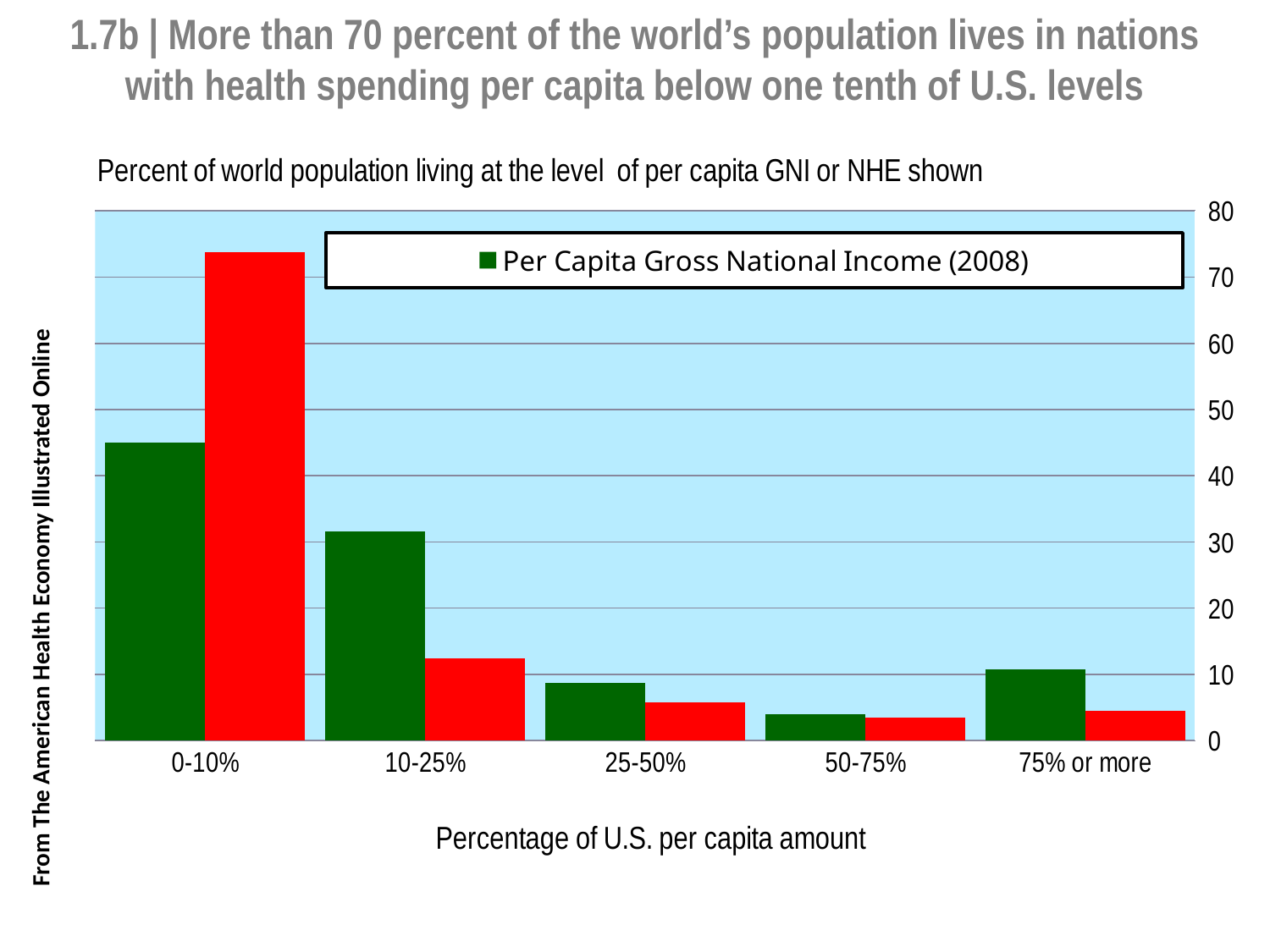
Which category has the highest value for Per Capita Gross National Income (2008)? 0-10% In the 10-25% category, which bar is taller, the green bar or the red bar? the green bar What kind of chart is shown on the slide? bar chart Is the value for Per Capita Gross National Income (2008) in the 0-10% category greater or less than 40? greater Is the value of the red bar in the 0-10% category greater or less than 70? greater Which category has the lowest value for Per Capita Gross National Income (2008)? 50-75% In the 0-10% category, which bar is taller, the green bar or the red bar? the red bar Do the red bars rise or fall from the 0-10% category to the 50-75% category? fall How many categories are shown on the x axis? 5 How many series does the legend list? 1 What is the label of the x axis? Percentage of U.S. per capita amount Is the value for Per Capita Gross National Income (2008) in the 75% or more category greater or less than 20? less